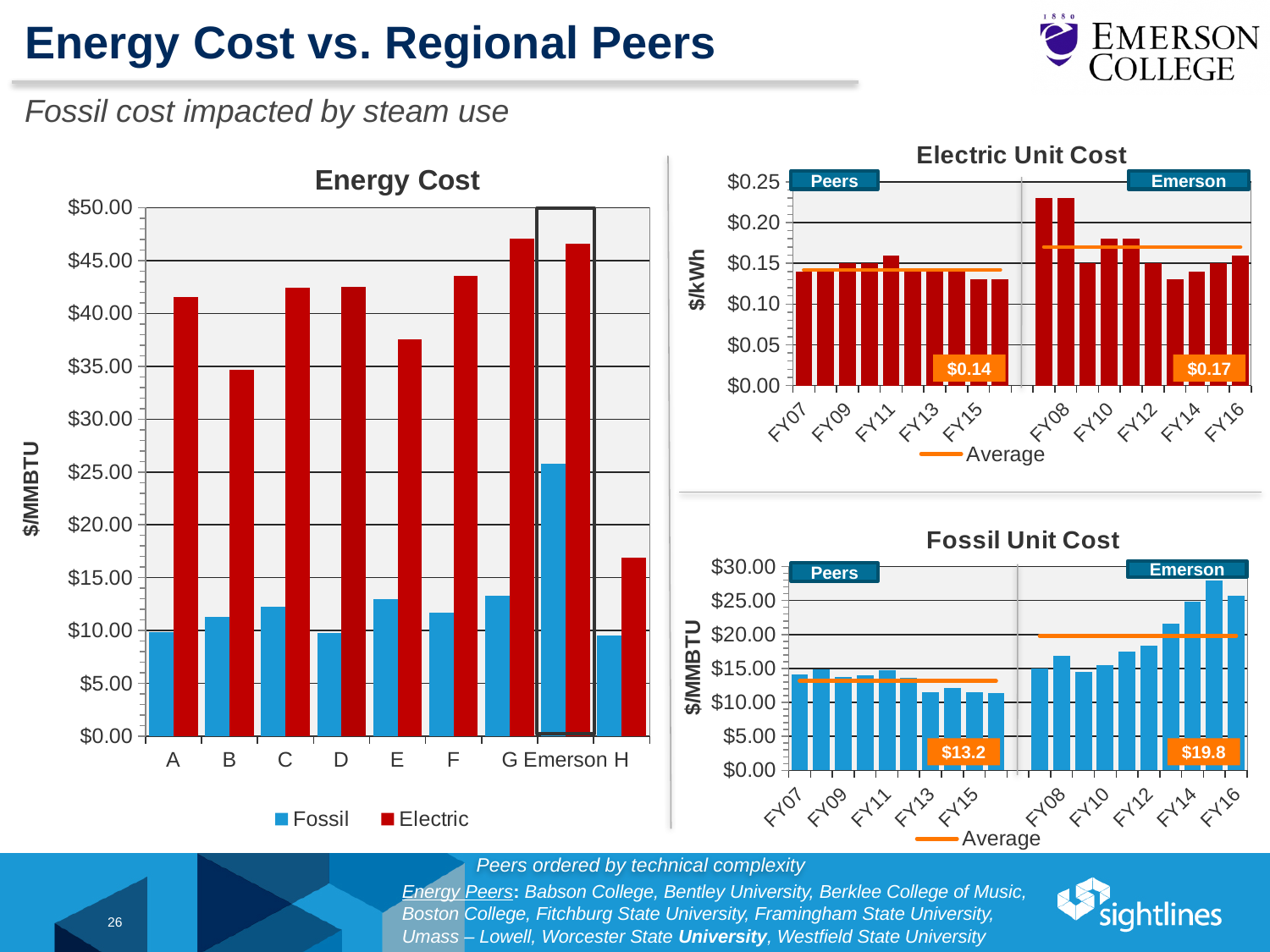
In the Fossil Unit Cost chart, what is the difference between the Emerson average and the Peers average? $6.6 In the Energy Cost chart, which category has the lowest Electric value? H In the Energy Cost chart, which category has the highest Fossil value? Emerson How many categories are shown on the x axis of the Energy Cost chart? 9 In the Electric Unit Cost chart, what is the labelled average for Peers? $0.14 In the Fossil Unit Cost chart, what is the labelled average for Emerson? $19.8 In the Electric Unit Cost chart, what is the labelled average for Emerson? $0.17 What kind of chart is the Energy Cost chart on the left? bar chart How many series does the legend of the Energy Cost chart list? 2 In the Energy Cost chart, is the Fossil value for Emerson greater or less than $20.00? greater In the Energy Cost chart, is the Electric value for H greater or less than $20.00? less What unit is shown on the y axis of the Electric Unit Cost chart? $/kWh